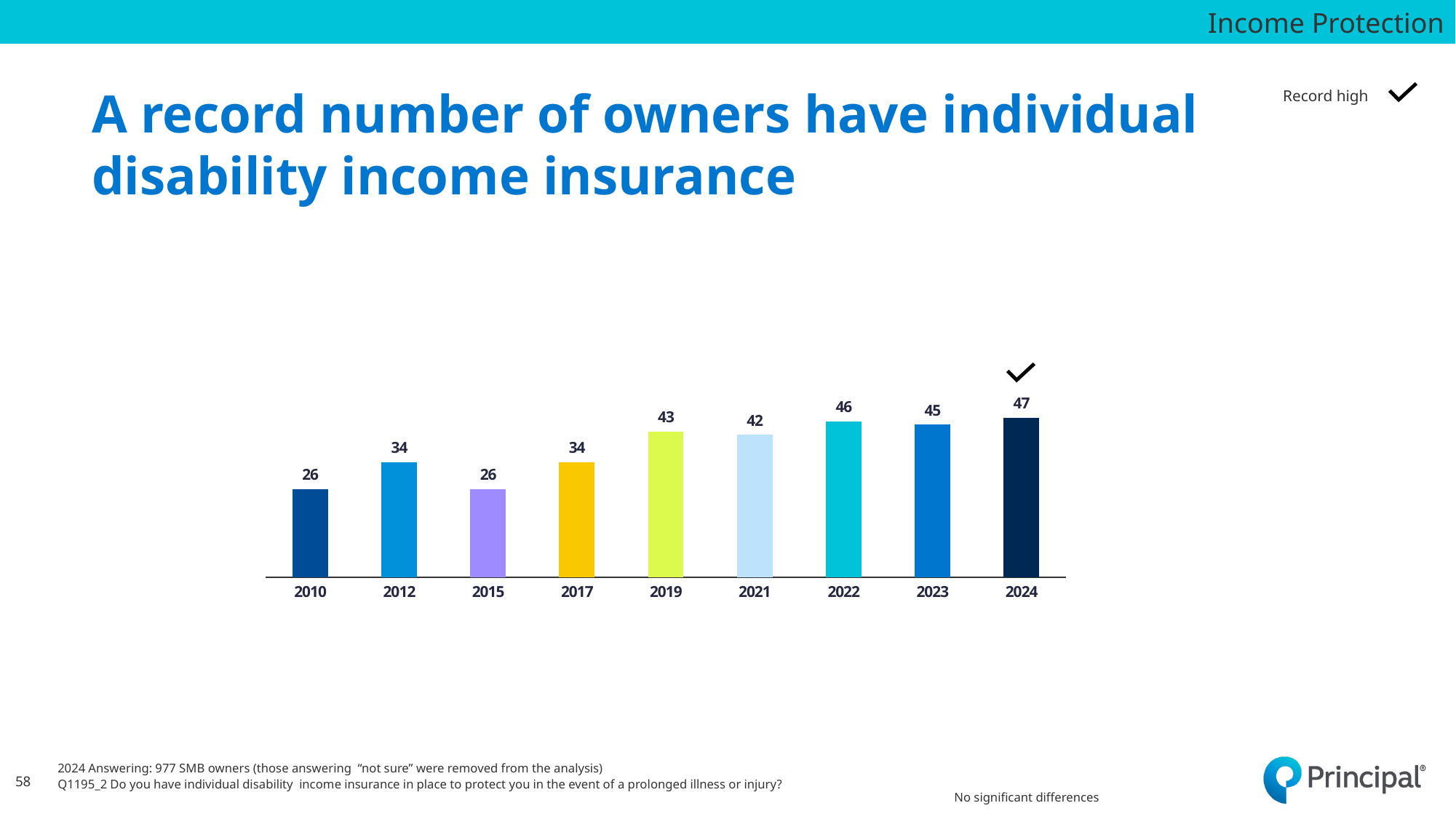
What is the value for 2024? 47 Which is larger, the value for 2019 or the value for 2021? 2019 Which year's bar is marked with a check mark? 2024 Which year has the highest value? 2024 Which is larger, the value for 2022 or the value for 2023? 2022 How many years are shown on the x axis? 9 What is the difference between the values for 2022 and 2021? 4 What is the difference between the values for 2024 and 2010? 21 What is the value for 2010? 26 What is the value for 2019? 43 Do the values generally rise or fall from 2010 to 2024? Rise What kind of chart is shown on the slide? Bar chart